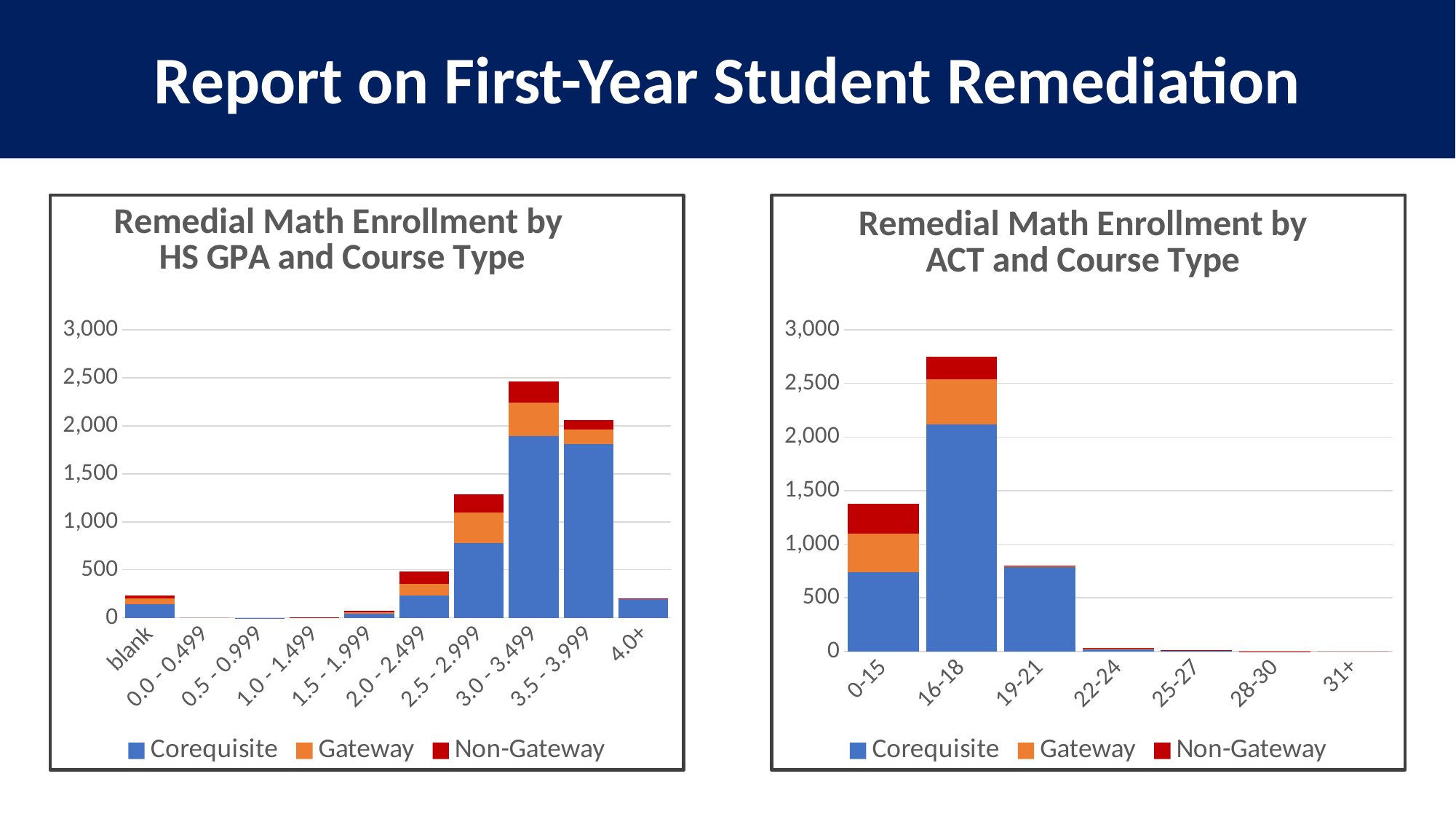
What type of chart is the 'Remedial Math Enrollment by HS GPA and Course Type' chart? stacked bar chart In the 'Remedial Math Enrollment by HS GPA and Course Type' chart, which GPA category has the tallest stacked bar? 3.0 - 3.499 In the 'Remedial Math Enrollment by ACT and Course Type' chart, which has the larger total: 0-15 or 19-21? 0-15 In the 'Remedial Math Enrollment by ACT and Course Type' chart, is the total for 16-18 greater or less than 2,500? greater In the 'Remedial Math Enrollment by ACT and Course Type' chart, is the total for 19-21 greater or less than 1,000? less Which series is shown in red in the legend of the 'Remedial Math Enrollment by HS GPA and Course Type' chart? Non-Gateway In the 'Remedial Math Enrollment by ACT and Course Type' chart, which ACT category has the tallest stacked bar? 16-18 How many GPA categories are shown on the x axis of the 'Remedial Math Enrollment by HS GPA and Course Type' chart? 10 In the 'Remedial Math Enrollment by HS GPA and Course Type' chart, is the total for 3.0 - 3.499 greater or less than 2,000? greater How many ACT categories are shown on the x axis of the 'Remedial Math Enrollment by ACT and Course Type' chart? 7 How many series does the legend list in the 'Remedial Math Enrollment by ACT and Course Type' chart? 3 In the 'Remedial Math Enrollment by HS GPA and Course Type' chart, which has the larger total: 3.0 - 3.499 or 3.5 - 3.999? 3.0 - 3.499